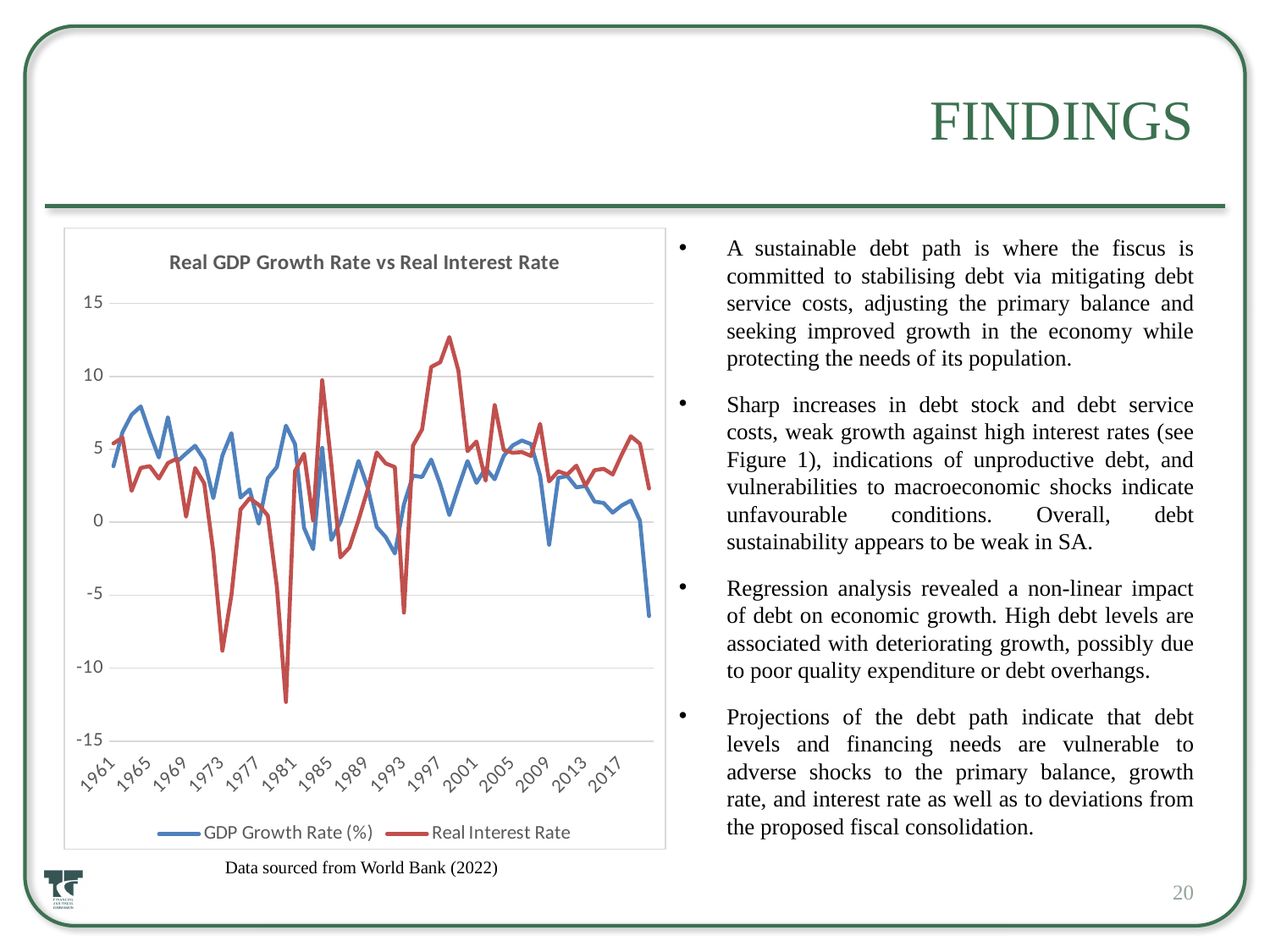
How many series does the legend of the chart list? 2 Is the lowest value of the Real Interest Rate series greater or less than -10? less What kind of chart is shown on the slide? Line chart Which series is drawn in red in the chart? Real Interest Rate Is the highest value of the Real Interest Rate series greater or less than 10? greater Which series reaches the highest value anywhere on the chart? Real Interest Rate Is the final value of the GDP Growth Rate (%) series, at the right end of the chart, greater or less than -5? less What is the title of the chart? Real GDP Growth Rate vs Real Interest Rate Which series reaches the lowest value anywhere on the chart? Real Interest Rate Around 1981, which series has the lower value, GDP Growth Rate (%) or Real Interest Rate? Real Interest Rate Does the GDP Growth Rate (%) series rise or fall over the last few years at the right end of the chart? fall